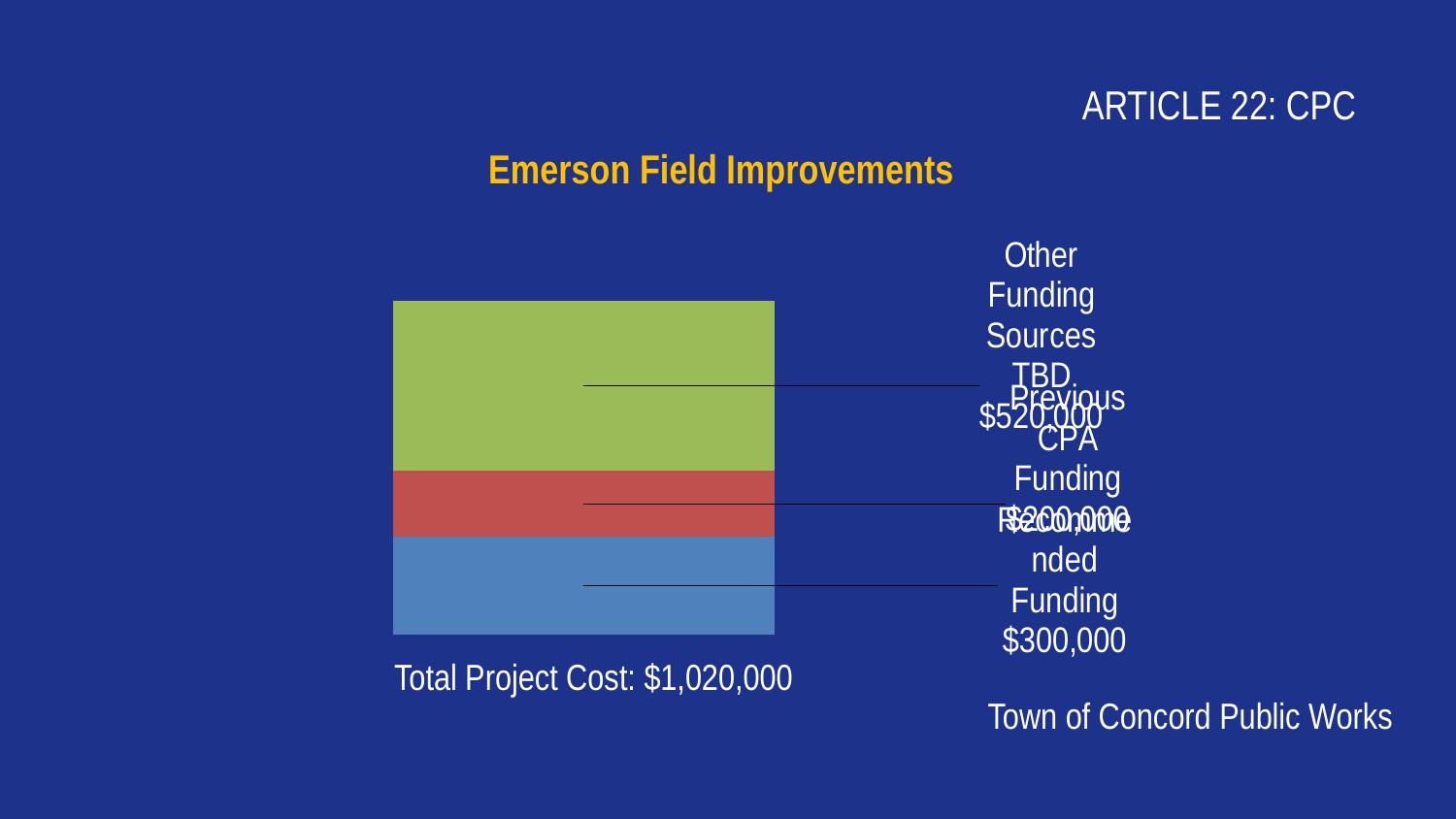
What is the total of the stacked bar? $1,020,000 How many segments make up the stacked bar? 3 Which funding segment is the smallest? Previous CPA Funding What colour is the Recommended Funding segment? blue What is the value of the Other Funding Sources TBD segment? $520,000 What is the title of the chart? Emerson Field Improvements Which is larger, Recommended Funding or Previous CPA Funding? Recommended Funding What is the value of the Recommended Funding segment? $300,000 Which funding segment is the largest? Other Funding Sources TBD What kind of chart is shown on the slide? stacked bar chart What is the value of the Previous CPA Funding segment? $200,000 What is the difference between the Other Funding Sources TBD segment and the Recommended Funding segment? $220,000